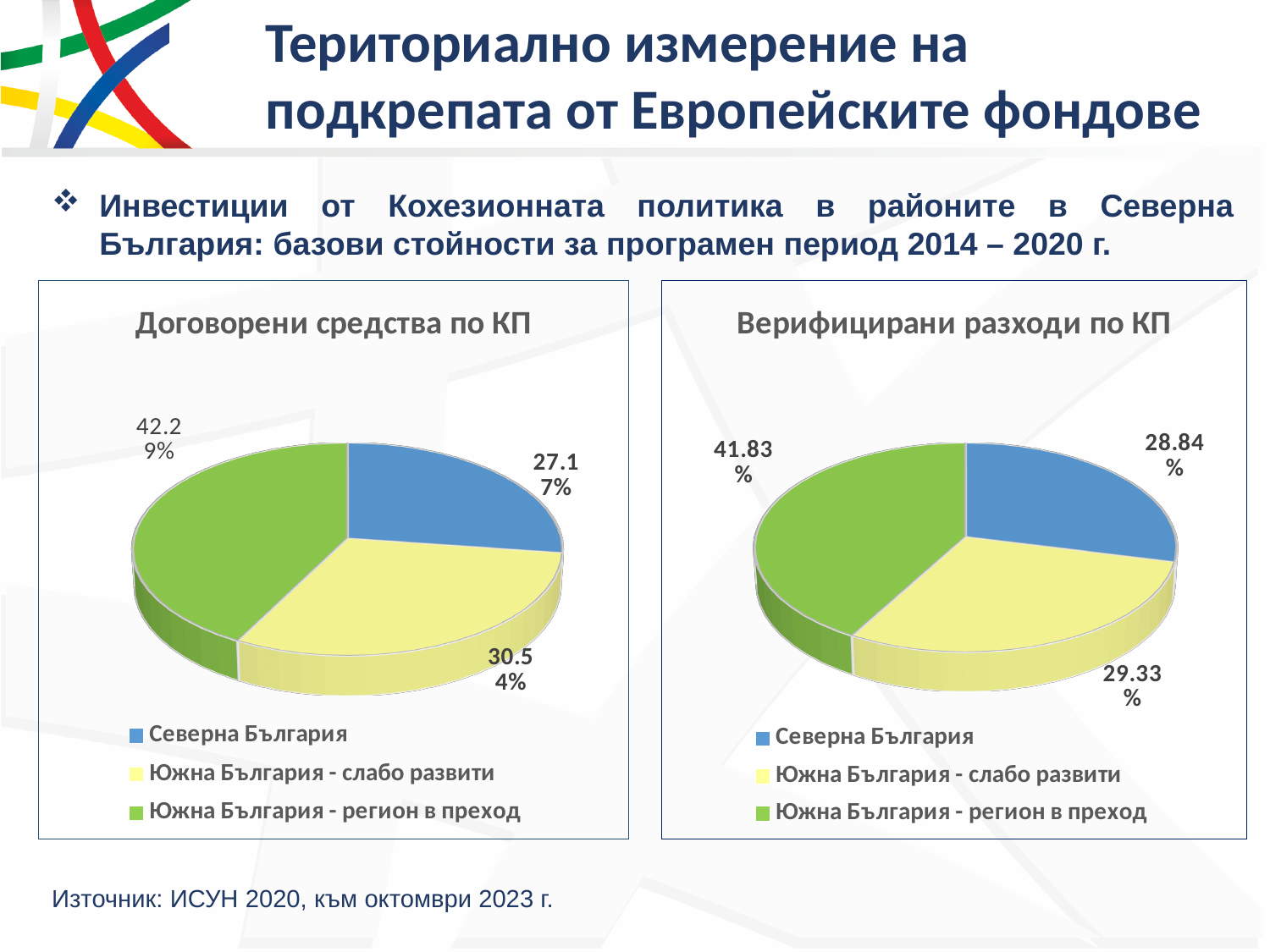
In the chart titled "Верифицирани разходи по КП", what is the share for Южна България - слабо развити? 29.33% How many categories does the legend of the chart titled "Договорени средства по КП" list? 3 In the chart titled "Верифицирани разходи по КП", what is the share for Северна България? 28.84% What type of chart is the chart titled "Верифицирани разходи по КП"? Pie chart In the chart titled "Верифицирани разходи по КП", which is larger: the share for Южна България - слабо развити or the share for Северна България? Южна България - слабо развити In the chart titled "Договорени средства по КП", what is the share for Южна България - слабо развити? 30.54% In the chart titled "Договорени средства по КП", what is the share for Северна България? 27.17% In the chart titled "Верифицирани разходи по КП", which category has the smallest share? Северна България In the chart titled "Договорени средства по КП", what is the difference between the shares of Южна България - регион в преход and Северна България? 15.12 percentage points In the chart titled "Договорени средства по КП", what is the share for Южна България - регион в преход? 42.29% In the chart titled "Договорени средства по КП", which category has the largest share? Южна България - регион в преход In the chart titled "Верифицирани разходи по КП", what is the share for Южна България - регион в преход? 41.83%